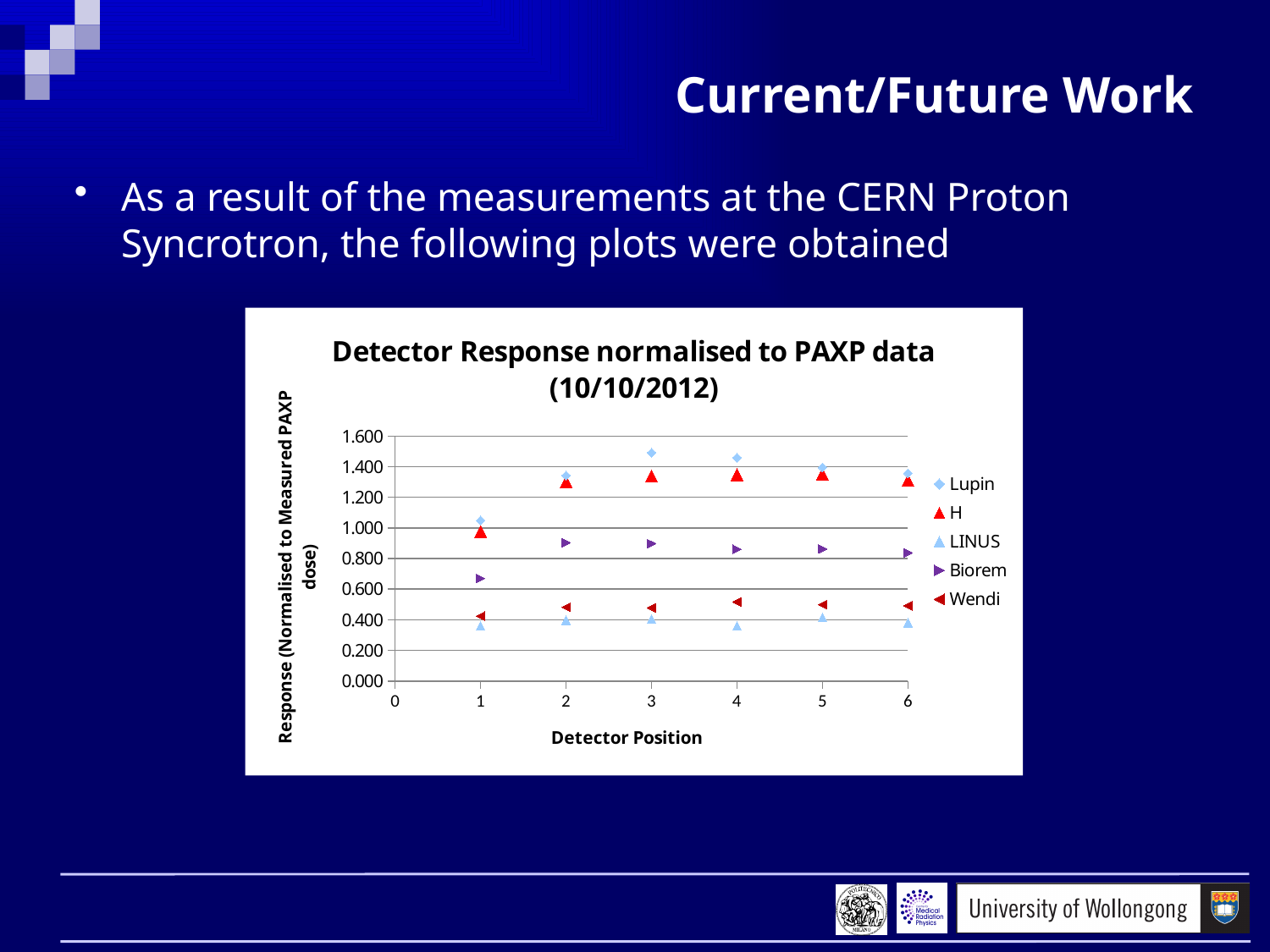
At detector position 2, which is larger: Biorem or Wendi? Biorem Is the value for H at detector position 1 greater or less than 1.200? less Do the Lupin values rise or fall from detector position 1 to detector position 3? rise Is the value for Lupin at detector position 3 greater or less than 1.400? greater Which series has the highest value at detector position 3? Lupin What is the label of the x axis? Detector Position Is the value for Biorem at detector position 1 greater or less than 0.800? less How many series does the legend list? 5 How many detector positions have data points plotted? 6 Which series has the lowest value at detector position 4? LINUS What kind of chart is shown on the slide? Scatter chart